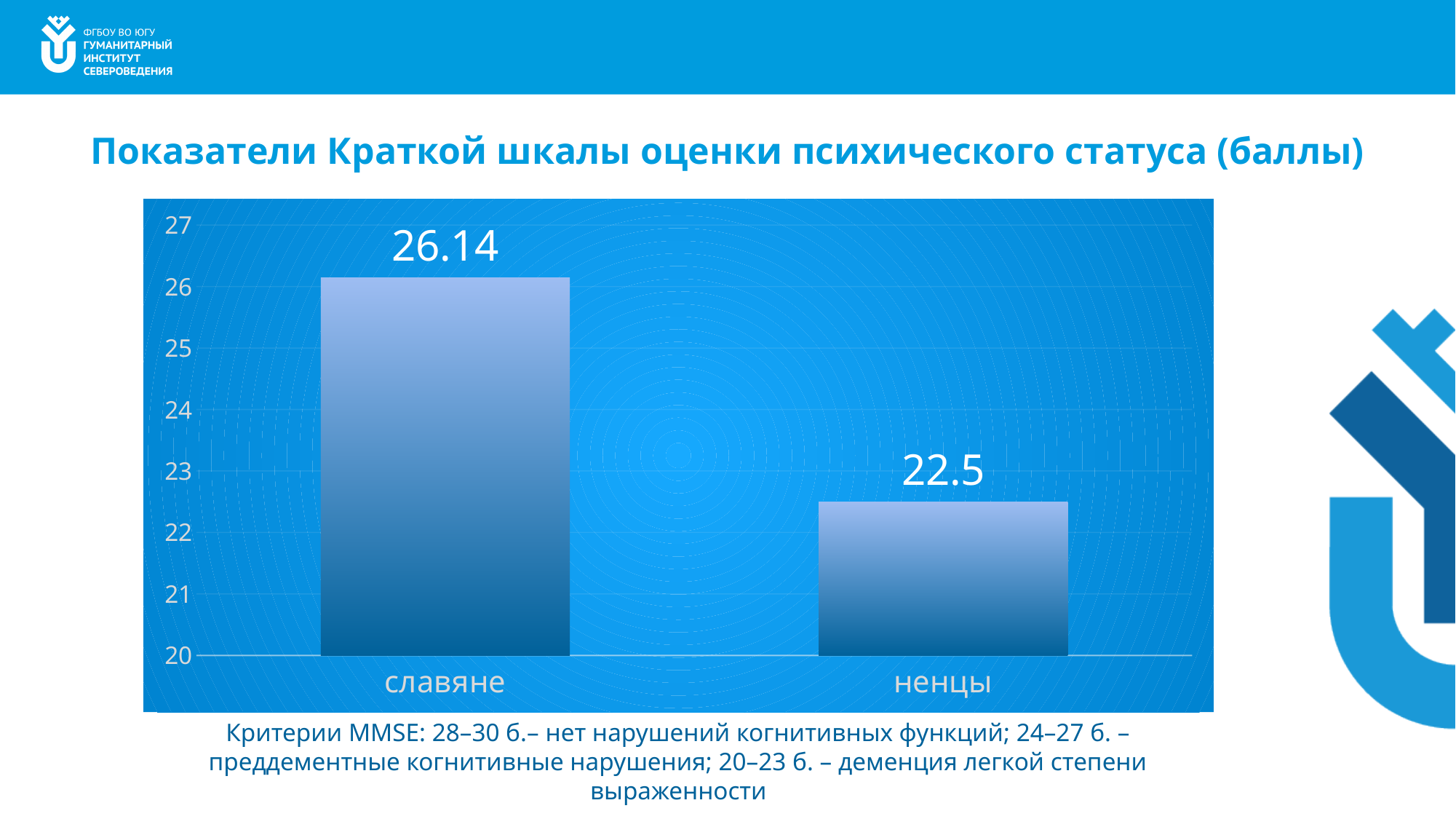
Is the value for славяне greater or less than 25? greater What is the value for славяне? 26.14 Is the value for ненцы greater or less than 24? less Which category has the lowest value? ненцы What is the lowest value shown on the vertical axis? 20 What is the difference between the values for славяне and ненцы? 3.64 Which category has the highest value? славяне What is the title of the slide above the chart? Показатели Краткой шкалы оценки психического статуса (баллы) What kind of chart is shown on the slide? bar chart Which is larger, the value for славяне or the value for ненцы? славяне What is the value for ненцы? 22.5 How many categories are shown in the chart? 2